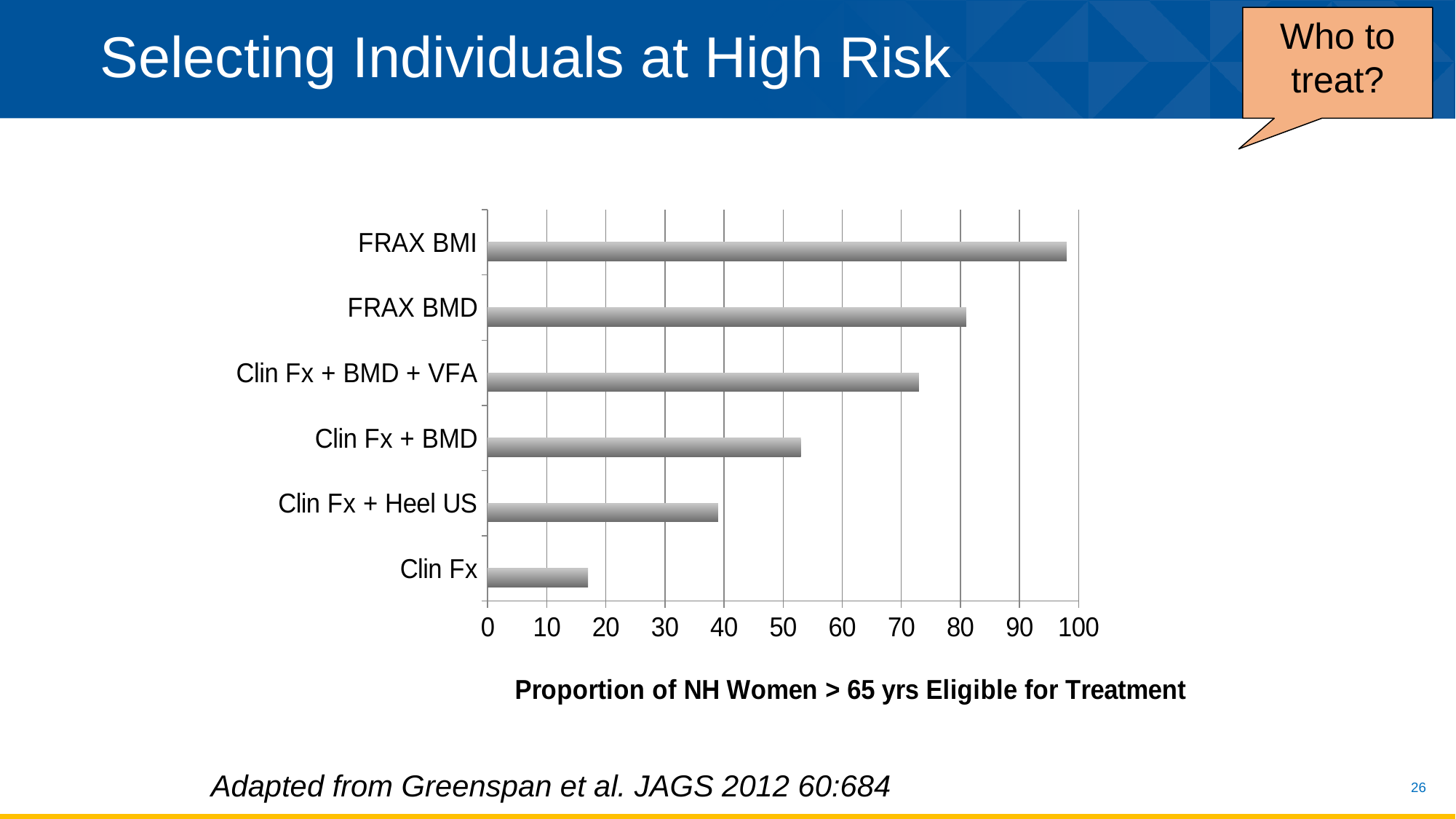
Which category has the lowest value in the chart? Clin Fx Is the value for FRAX BMD greater or less than 90? less Is the value for Clin Fx greater or less than 20? less Is the value for Clin Fx + BMD greater or less than 60? less What is the axis title shown below the chart? Proportion of NH Women > 65 yrs Eligible for Treatment What kind of chart is shown on the slide? bar chart How many categories are plotted in the chart? 6 Which category has the highest value in the chart? FRAX BMI Which is larger, the value for Clin Fx + BMD or the value for Clin Fx + Heel US? Clin Fx + BMD